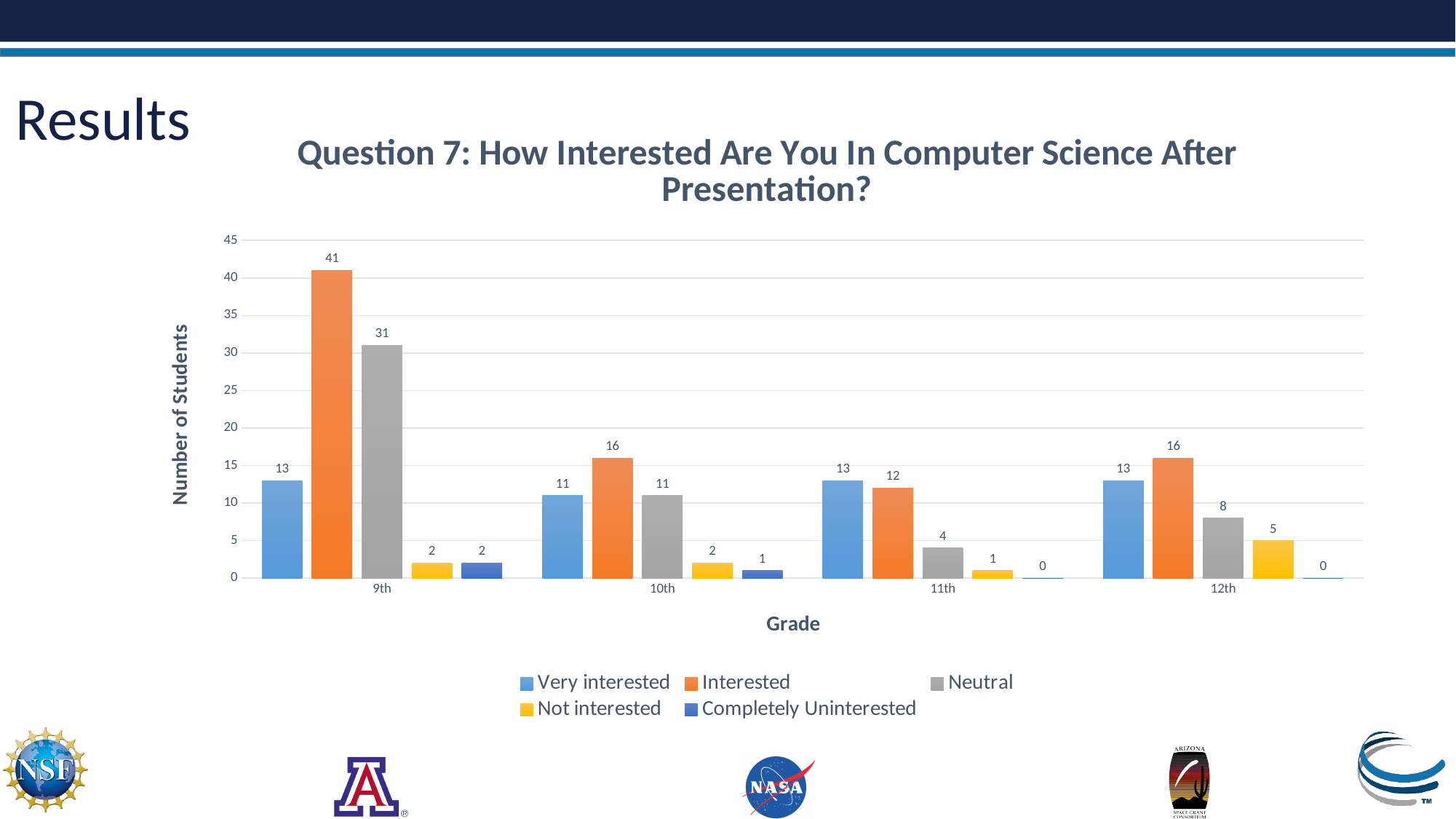
Which grade has the highest number of "Interested" students? 9th How many grade categories are shown on the x axis? 4 How many 9th grade students answered "Interested"? 41 Which is larger for 12th grade: "Very interested" or "Not interested"? Very interested What is the value for "Neutral" in 12th grade? 8 How many 11th grade students answered "Completely Uninterested"? 0 Which grade has the lowest number of "Neutral" students? 11th How many series does the legend list? 5 Is the value for "Interested" in 9th grade greater or less than 40? greater What is the label of the y axis? Number of Students What is the difference between the "Interested" and "Neutral" values for 9th grade? 10 What kind of chart is shown on the slide? Bar chart